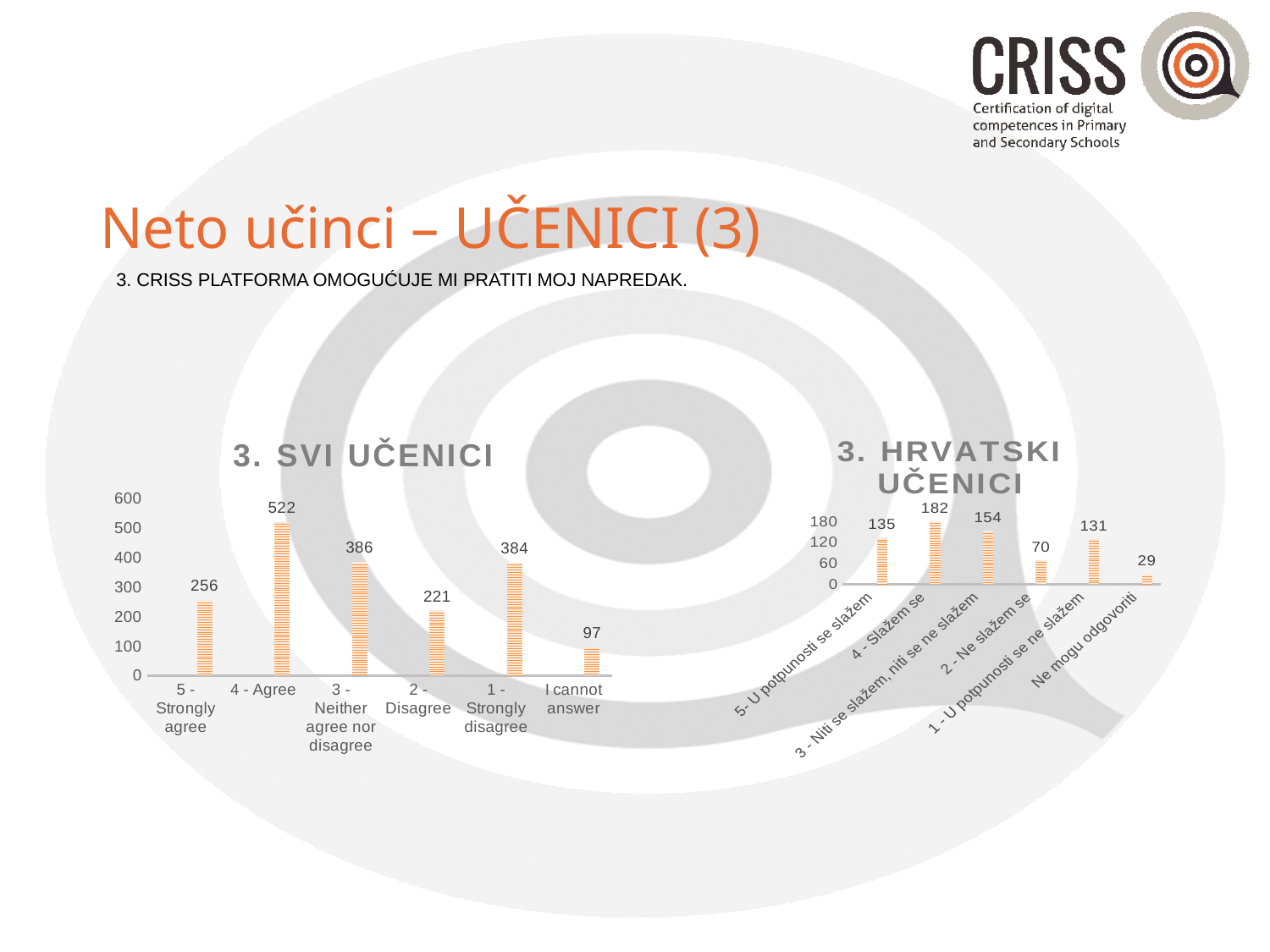
In the chart titled "3. SVI UČENICI", which category has the lowest value? I cannot answer In the chart titled "3. SVI UČENICI", what is the value for "I cannot answer"? 97 In the chart titled "3. SVI UČENICI", what is the value for "4 - Agree"? 522 In the chart titled "3. SVI UČENICI", how many categories are shown on the x axis? 6 In the chart titled "3. HRVATSKI UČENICI", what is the value for "4 - Slažem se"? 182 In the chart titled "3. HRVATSKI UČENICI", which category has the lowest value? Ne mogu odgovoriti In the chart titled "3. SVI UČENICI", which category has the highest value? 4 - Agree In the chart titled "3. HRVATSKI UČENICI", which is larger: the value for "5 - U potpunosti se slažem" or the value for "1 - U potpunosti se ne slažem"? 5 - U potpunosti se slažem In the chart titled "3. SVI UČENICI", what is the difference between the values for "4 - Agree" and "5 - Strongly agree"? 266 In the chart titled "3. HRVATSKI UČENICI", what is the value for "2 - Ne slažem se"? 70 What kind of chart is the chart titled "3. SVI UČENICI"? Bar chart In the chart titled "3. HRVATSKI UČENICI", what is the difference between the values for "4 - Slažem se" and "3 - Niti se slažem, niti se ne slažem"? 28